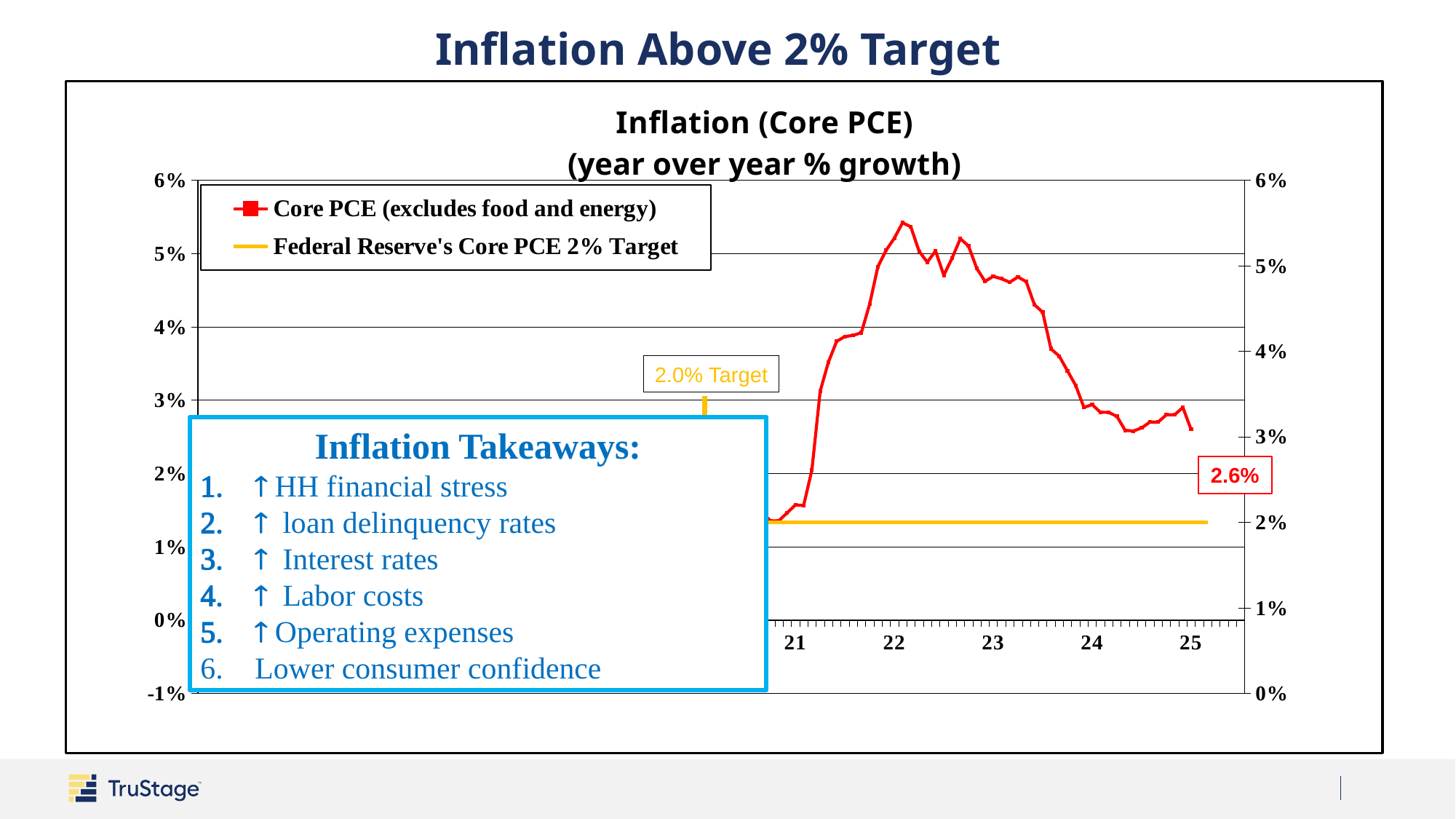
What is the Federal Reserve's Core PCE target value shown on the chart? 2.0% What type of chart is shown on the slide? line chart Does the Core PCE line rise or fall from its peak near 22 to 25? fall Is the Core PCE value at the 24 tick greater or less than 2%? greater Which is larger, the latest Core PCE value or the Federal Reserve's 2% target? the latest Core PCE value (2.6%) By how much does the latest Core PCE value of 2.6% exceed the 2.0% target? 0.6% What colour is the Core PCE (excludes food and energy) line? red What is the title of the chart? Inflation (Core PCE) (year over year % growth) Near which year tick does the Core PCE line reach its highest point? 22 How many series does the legend of the Inflation (Core PCE) chart list? 2 What is the most recent Core PCE value labeled on the chart? 2.6% Is the peak Core PCE value on the chart greater or less than 5%? greater